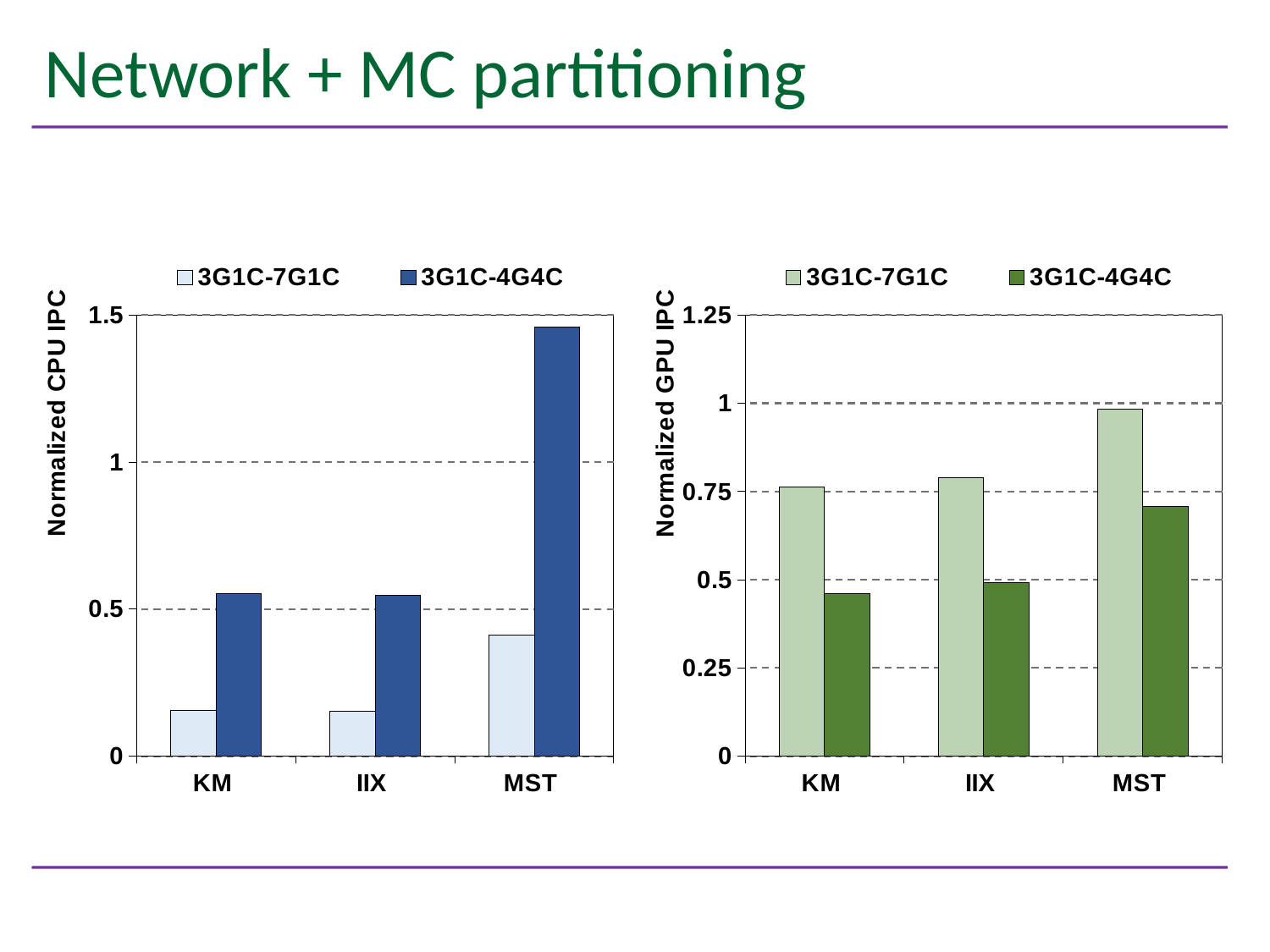
In the left chart (Normalized CPU IPC), which category has the highest 3G1C-4G4C bar? MST What kind of chart is the left chart (Normalized CPU IPC)? bar chart How many categories are shown on the x axis of the left chart (Normalized CPU IPC)? 3 In the right chart (Normalized GPU IPC), which category has the lowest 3G1C-4G4C bar? KM What is the y-axis label of the right chart? Normalized GPU IPC How many series does the legend of the right chart (Normalized GPU IPC) list? 2 In the left chart (Normalized CPU IPC), for MST, which series has the larger value: 3G1C-7G1C or 3G1C-4G4C? 3G1C-4G4C In the right chart (Normalized GPU IPC), is the 3G1C-4G4C value for KM greater or less than 0.5? less In the right chart (Normalized GPU IPC), which category has the highest 3G1C-7G1C bar? MST In the right chart (Normalized GPU IPC), is the 3G1C-7G1C value for MST greater or less than 1? less In the left chart (Normalized CPU IPC), is the 3G1C-4G4C value for MST greater or less than 1? greater In the right chart (Normalized GPU IPC), for IIX, which series has the larger value: 3G1C-7G1C or 3G1C-4G4C? 3G1C-7G1C